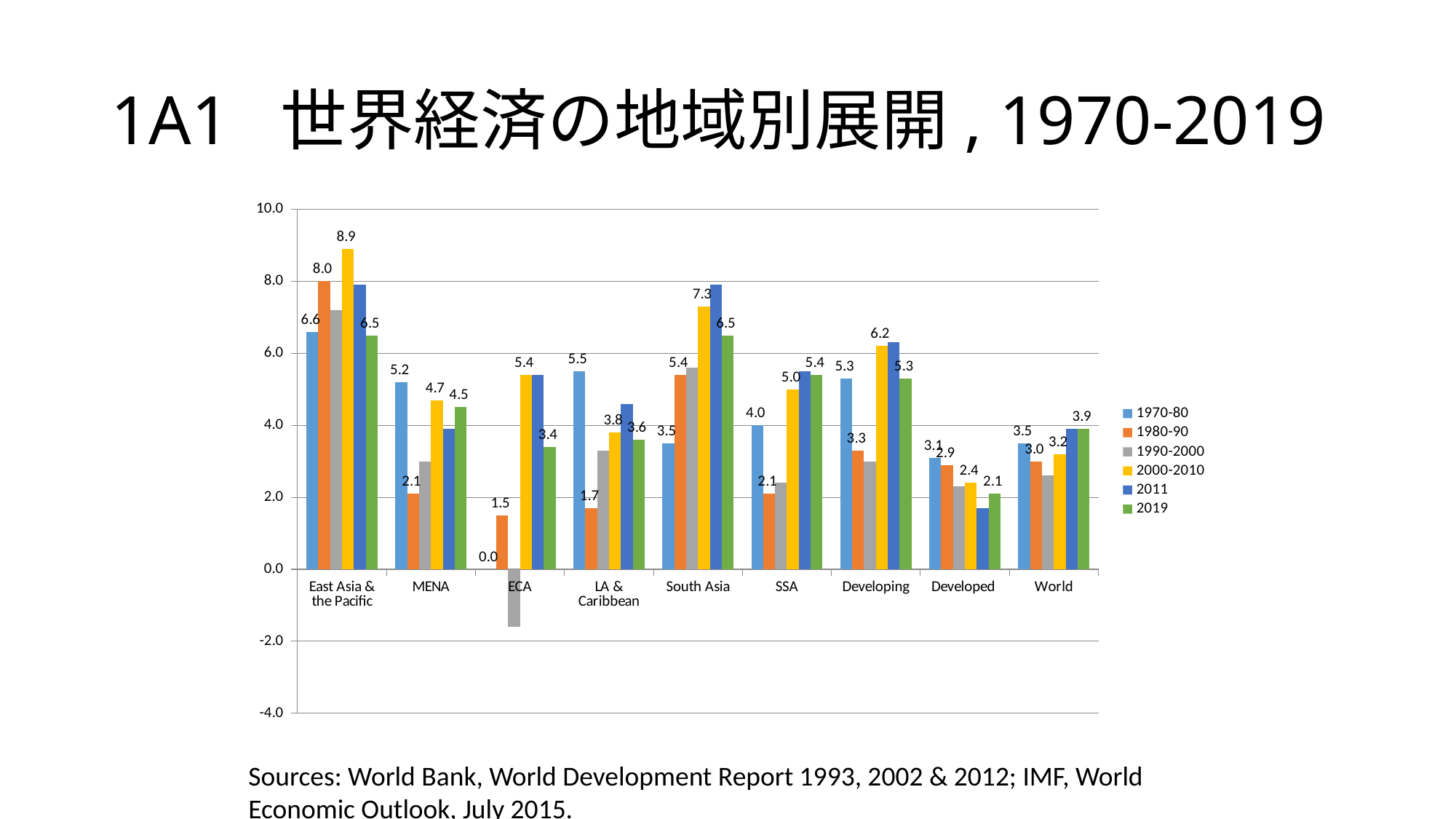
Which category has the lowest value in the 1970-80 series? ECA Is the value for ECA in the 1990-2000 series greater or less than 0.0? less For the Developed category, do the labelled values fall or rise from 1970-80 through 2019? fall What is the value for ECA in the 1980-90 series? 1.5 What is the difference between the 1980-90 value and the 1970-80 value for East Asia & the Pacific? 1.4 Which is larger in the 2000-2010 series: South Asia or Developing? South Asia Which category has the highest value in the 2000-2010 series? East Asia & the Pacific How many categories are shown on the x axis? 9 What is the value for World in the 2019 series? 3.9 What kind of chart is shown on the slide? bar chart How many series does the legend list? 6 What is the value for East Asia & the Pacific in the 2000-2010 series? 8.9